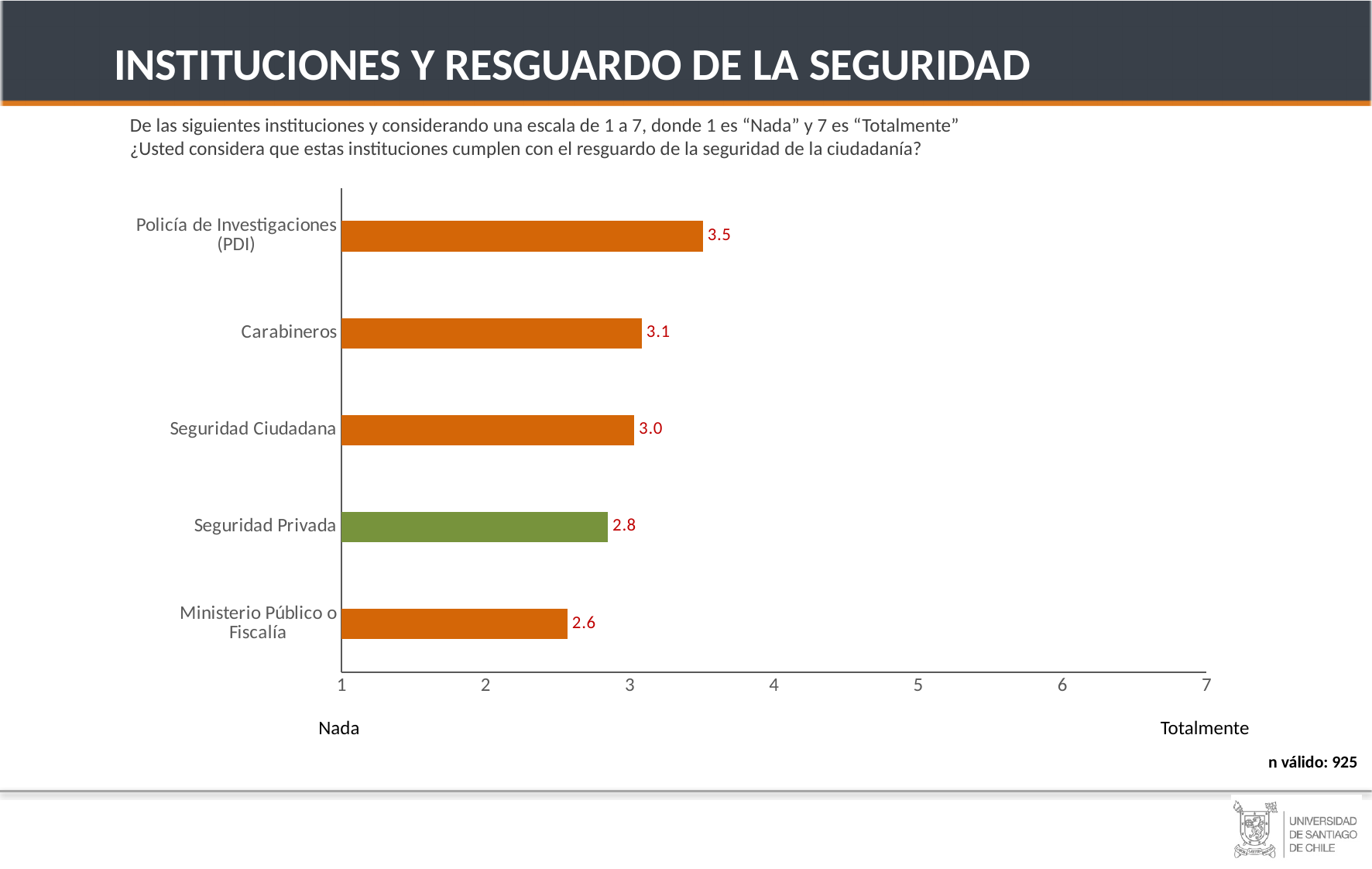
Is the value for Seguridad Privada greater or less than 3? less What is the value for Policía de Investigaciones (PDI)? 3.5 What is the value for Ministerio Público o Fiscalía? 2.6 Which bar is shown in a different colour (green) from the others? Seguridad Privada What is the difference between the values for Policía de Investigaciones (PDI) and Ministerio Público o Fiscalía? 0.9 How many institutions are shown in the chart? 5 Which institution has the lowest value? Ministerio Público o Fiscalía What kind of chart is shown on the slide? bar chart Which has a larger value, Carabineros or Seguridad Ciudadana? Carabineros What is the value for Seguridad Privada? 2.8 What is the value for Carabineros? 3.1 Which institution has the highest value? Policía de Investigaciones (PDI)